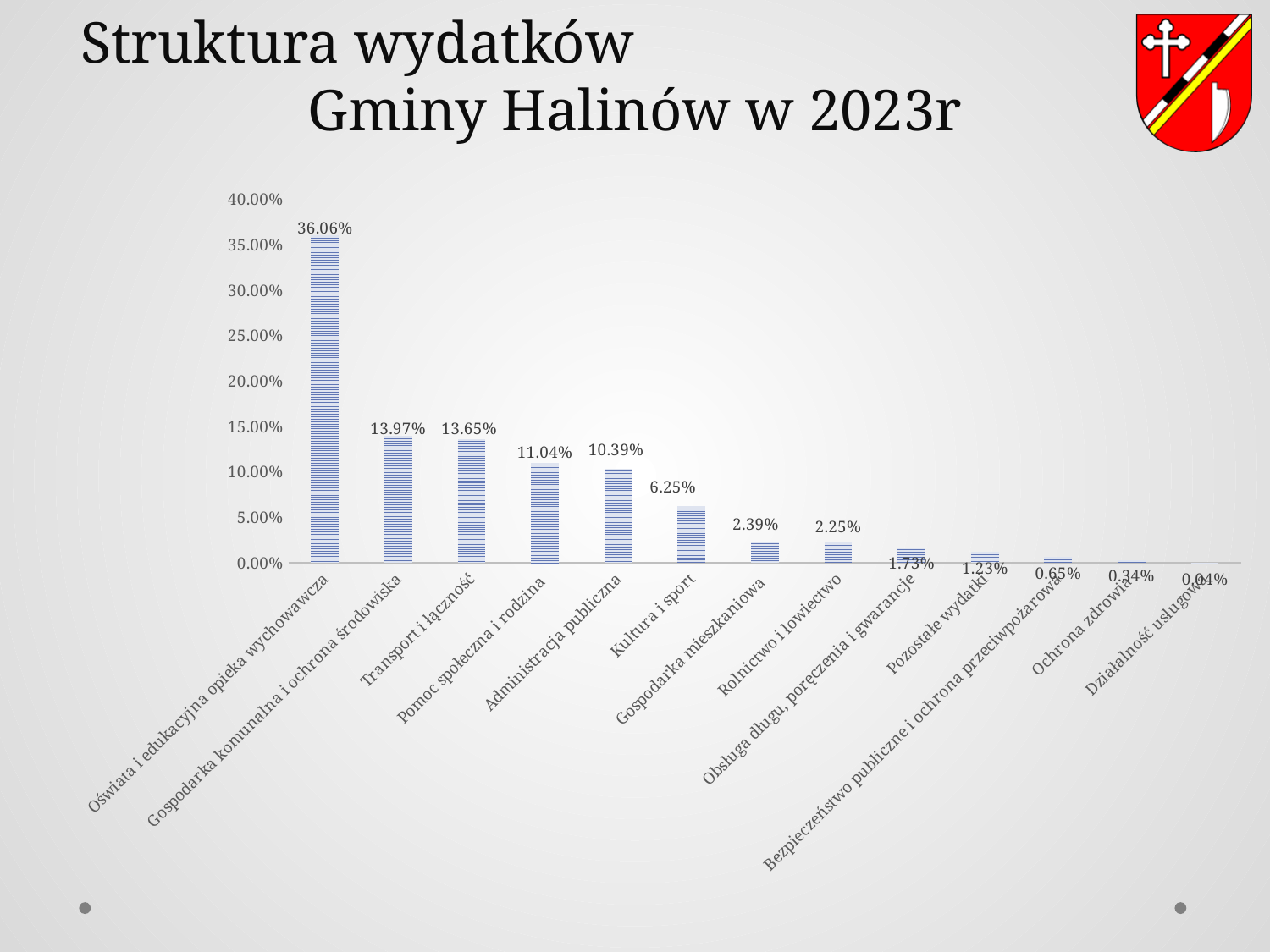
What is the value for Transport i łączność? 13.65% What is the difference between the values for Oświata i edukacyjna opieka wychowawcza and Gospodarka komunalna i ochrona środowiska? 22.09% Which category has the lowest value? Działalność usługowa What is the value for Ochrona zdrowia? 0.34% Which category has the highest value? Oświata i edukacyjna opieka wychowawcza How many categories are shown in the chart? 13 Do the values rise or fall from left to right along the x axis? Fall What is the difference between the values for Pomoc społeczna i rodzina and Administracja publiczna? 0.65% Which is larger, the value for Gospodarka mieszkaniowa or the value for Rolnictwo i łowiectwo? Gospodarka mieszkaniowa What is the value for Kultura i sport? 6.25% What kind of chart is shown on the slide? Bar chart What is the value for Oświata i edukacyjna opieka wychowawcza? 36.06%